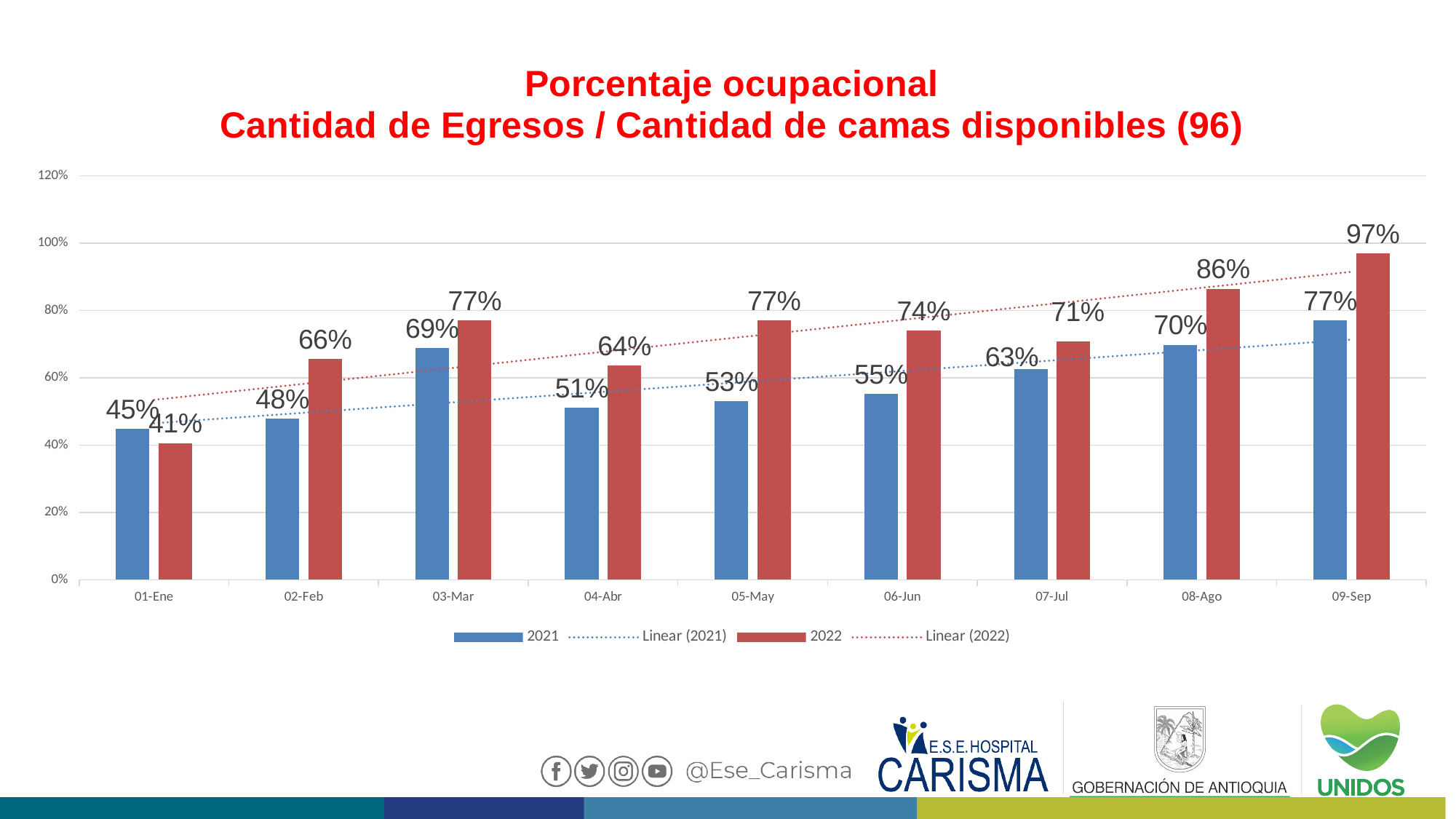
Which is larger for 01-Ene, the 2021 value or the 2022 value? 2021 How many entries does the legend list? 4 What is the 2022 value for 09-Sep? 97% Which month has the lowest 2021 value? 01-Ene Does the 2022 value rise or fall from 07-Jul to 09-Sep? Rise Which colour represents the 2022 series? Red What is the difference between the 2022 and 2021 values for 08-Ago? 16% What kind of chart is shown on the slide? Bar chart What is the 2021 value for 03-Mar? 69% How many months are shown on the x axis? 9 Which month has the highest 2022 value? 09-Sep What is the 2022 value for 01-Ene? 41%